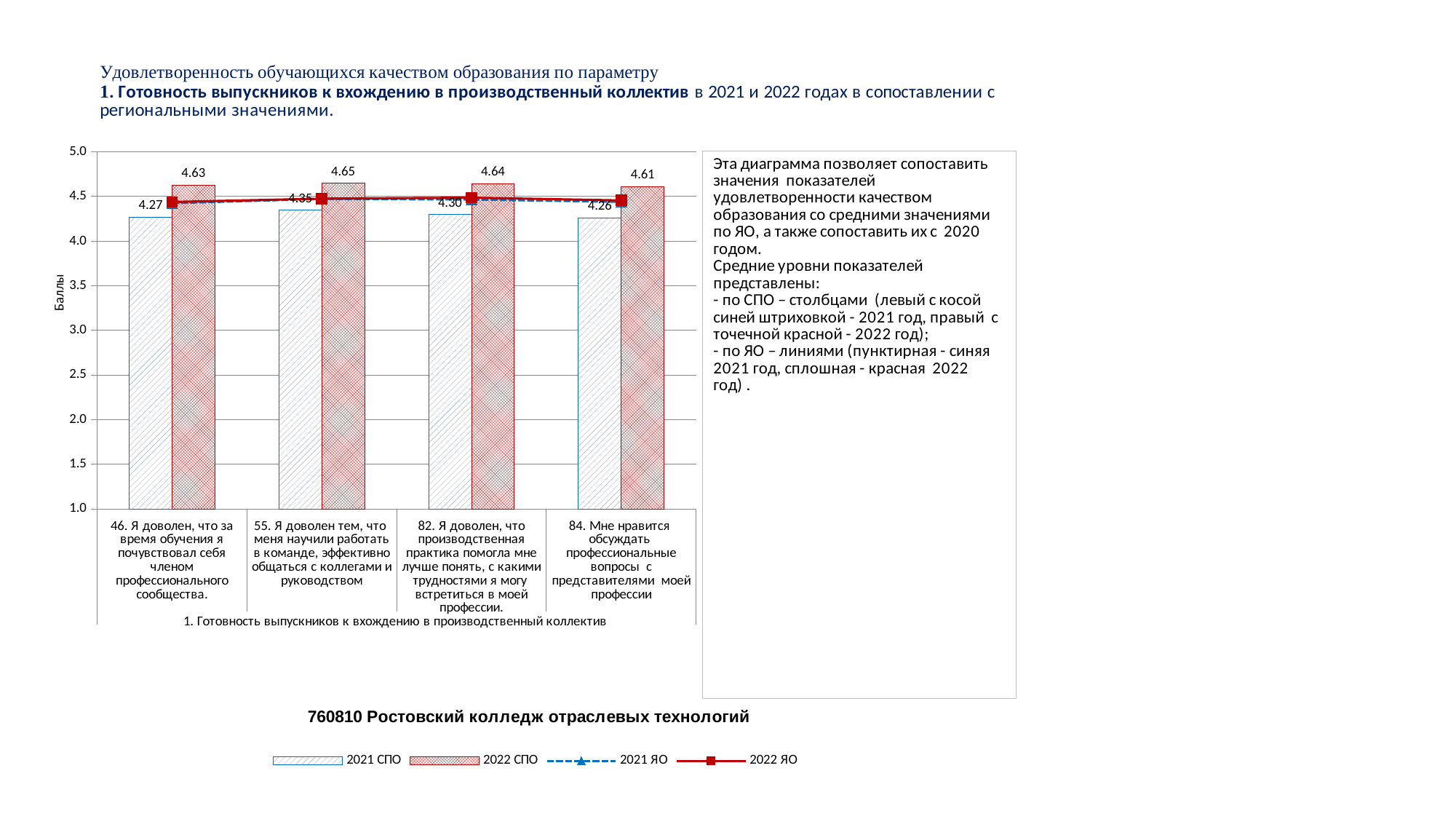
What is the label of the vertical axis of the chart? Баллы Which is larger for item 82: the 2021 СПО value or the 2022 СПО value? 2022 СПО Which item has the lowest 2021 СПО value? 84. Мне нравится обсуждать профессиональные вопросы с представителями моей профессии What is the 2021 СПО value for item 46 (Я доволен, что за время обучения я почувствовал себя членом профессионального сообщества)? 4.27 What is the 2022 СПО value for item 55 (Я доволен тем, что меня научили работать в команде)? 4.65 How many series does the chart legend list? 4 How many items (categories) are shown on the x axis of the chart? 4 Is the 2021 СПО value for item 55 greater or less than 4.5? less What is the difference between the 2022 СПО and 2021 СПО values for item 46? 0.36 What is the 2022 СПО value for item 84 (Мне нравится обсуждать профессиональные вопросы с представителями моей профессии)? 4.61 What is the 2021 СПО value for item 82 (Я доволен, что производственная практика помогла мне лучше понять...)? 4.30 Which item has the highest 2022 СПО value? 55. Я доволен тем, что меня научили работать в команде, эффективно общаться с коллегами и руководством